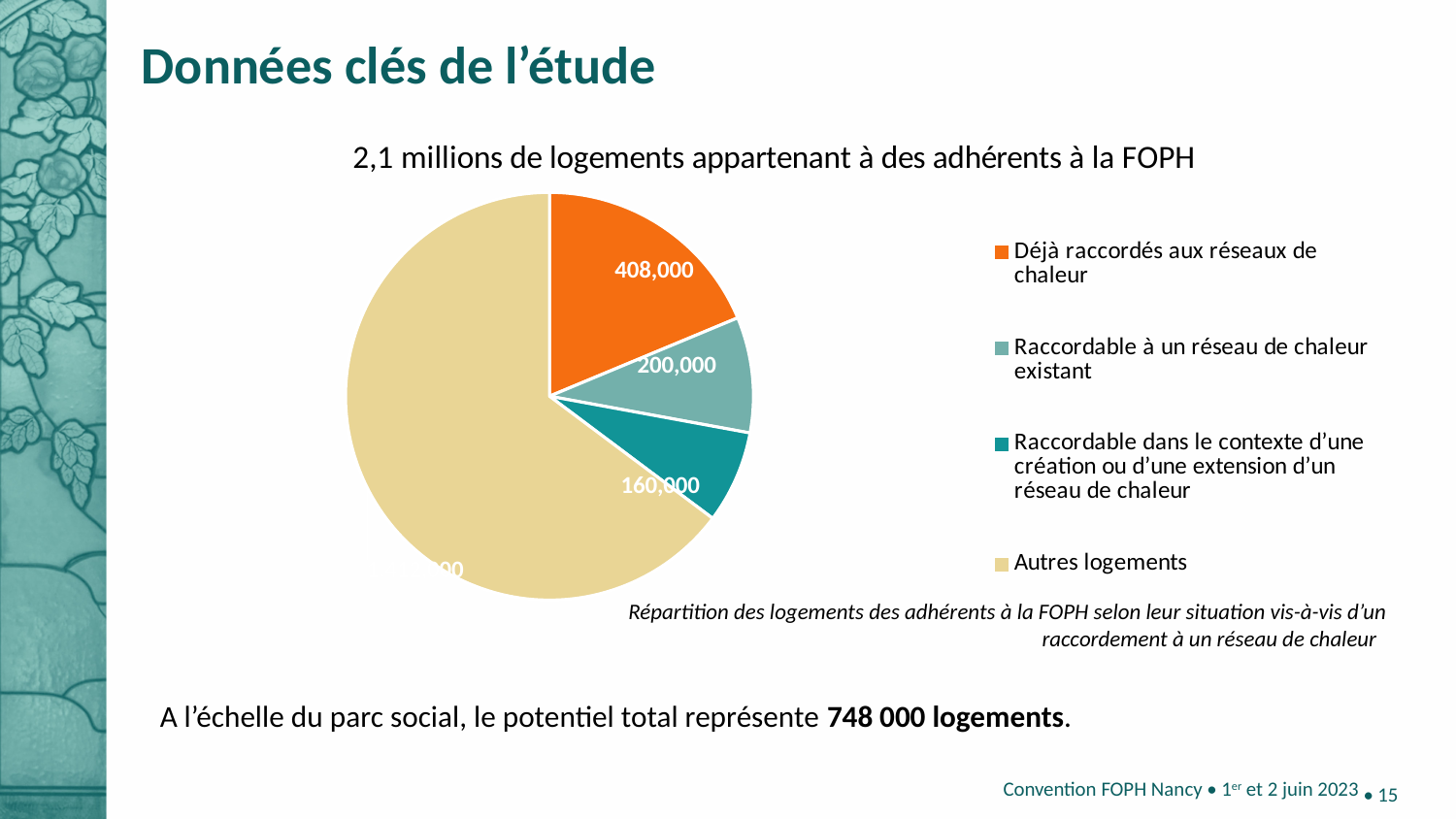
What is the value for 'Raccordable à un réseau de chaleur existant' in the pie chart? 200,000 What is the value for 'Raccordable dans le contexte d'une création ou d'une extension d'un réseau de chaleur' in the pie chart? 160,000 How many entries does the legend of the pie chart list? 4 How many slices does the pie chart have? 4 Which category has the smallest slice in the pie chart? Raccordable dans le contexte d'une création ou d'une extension d'un réseau de chaleur Which is larger: the slice for 'Déjà raccordés aux réseaux de chaleur' or the slice for 'Raccordable à un réseau de chaleur existant'? Déjà raccordés aux réseaux de chaleur What is the difference between the values for 'Déjà raccordés aux réseaux de chaleur' and 'Raccordable à un réseau de chaleur existant'? 208,000 What is the difference between the values for 'Raccordable à un réseau de chaleur existant' and 'Raccordable dans le contexte d'une création ou d'une extension d'un réseau de chaleur'? 40,000 Which category has the largest slice in the pie chart? Autres logements What colour is the slice for 'Déjà raccordés aux réseaux de chaleur' in the pie chart? Orange What kind of chart is shown on the slide? Pie chart What is the value for 'Déjà raccordés aux réseaux de chaleur' in the pie chart? 408,000